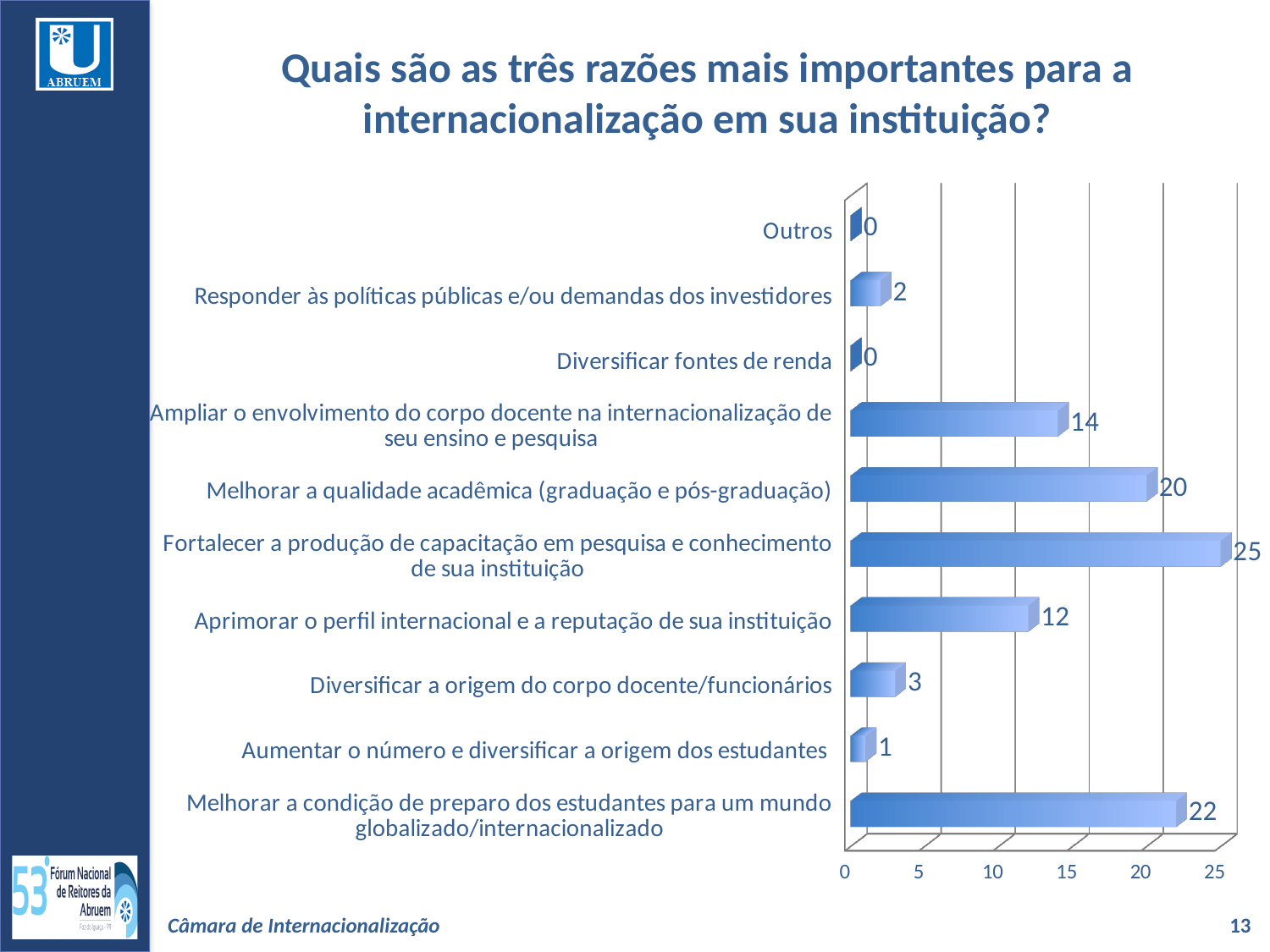
How many categories have a value of 0? 2 What is the title of the slide containing the chart? Quais são as três razões mais importantes para a internacionalização em sua instituição? What kind of chart is shown on the slide? Bar chart What is the value for "Responder às políticas públicas e/ou demandas dos investidores"? 2 How many categories are shown on the chart? 10 Which category has the highest value? Fortalecer a produção de capacitação em pesquisa e conhecimento de sua instituição What is the value for "Aumentar o número e diversificar a origem dos estudantes"? 1 What is the difference between the values for "Melhorar a condição de preparo dos estudantes para um mundo globalizado/internacionalizado" and "Ampliar o envolvimento do corpo docente na internacionalização de seu ensino e pesquisa"? 8 What is the value for "Aprimorar o perfil internacional e a reputação de sua instituição"? 12 What is the value for "Melhorar a qualidade acadêmica (graduação e pós-graduação)"? 20 What is the value for "Diversificar a origem do corpo docente/funcionários"? 3 Which is larger: the value for "Melhorar a qualidade acadêmica (graduação e pós-graduação)" or the value for "Melhorar a condição de preparo dos estudantes para um mundo globalizado/internacionalizado"? Melhorar a condição de preparo dos estudantes para um mundo globalizado/internacionalizado